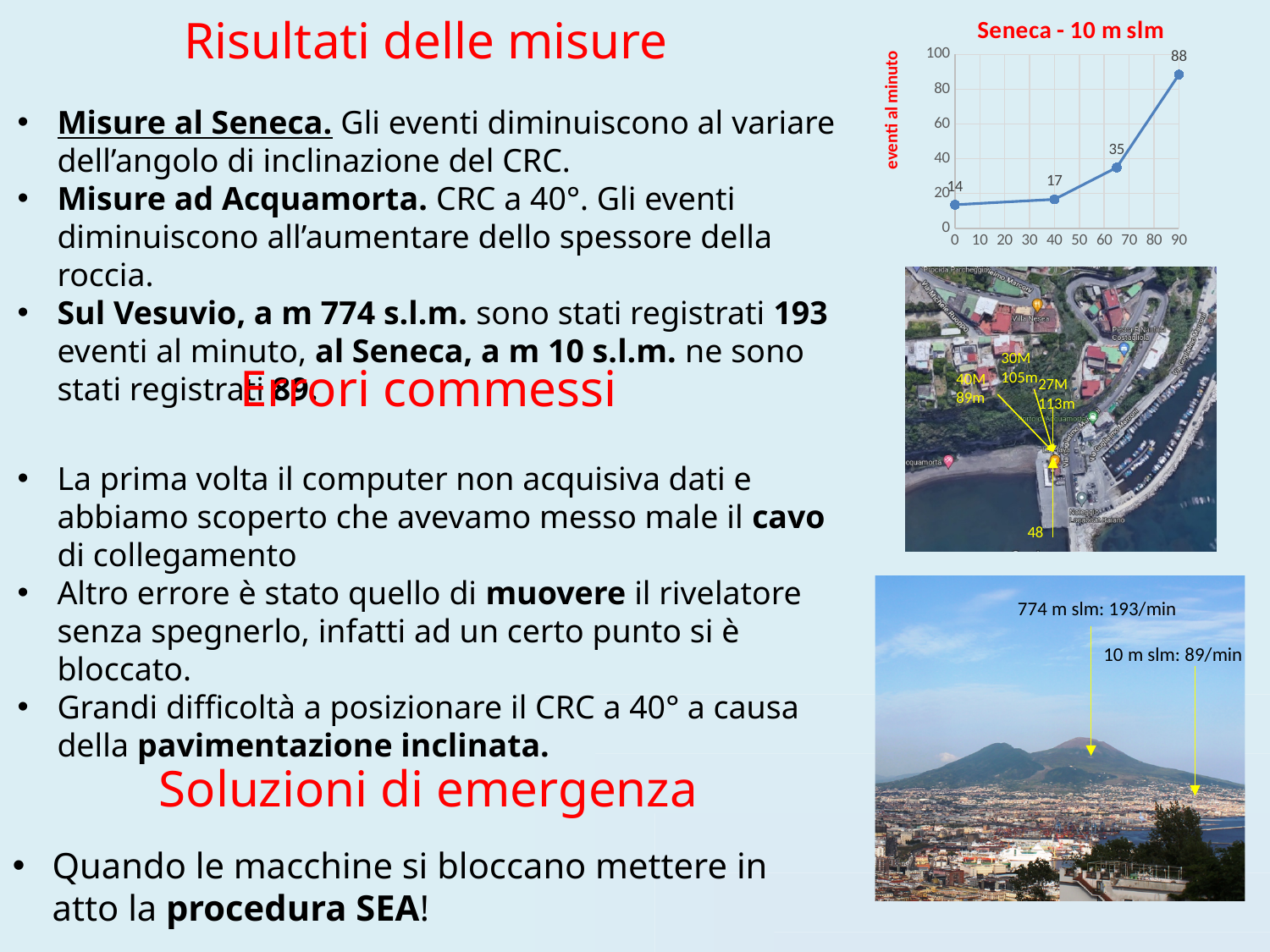
What is the value of the highest data point on the chart? 88 How many data points are plotted on the line? 4 What type of chart is shown on the slide? line chart What is the label of the vertical axis of the chart? eventi al minuto Which is larger, the value at x = 0 or the value at x = 90? the value at x = 90 What is the value of the data point at x = 40? 17 What is the value of the third data point along the line? 35 What is the difference between the highest and lowest values on the chart? 74 What is the difference between the third data point (35) and the second data point (17)? 18 What is the title of the chart? Seneca - 10 m slm What is the value of the lowest data point on the chart? 14 Do the values rise or fall as x increases along the chart? rise